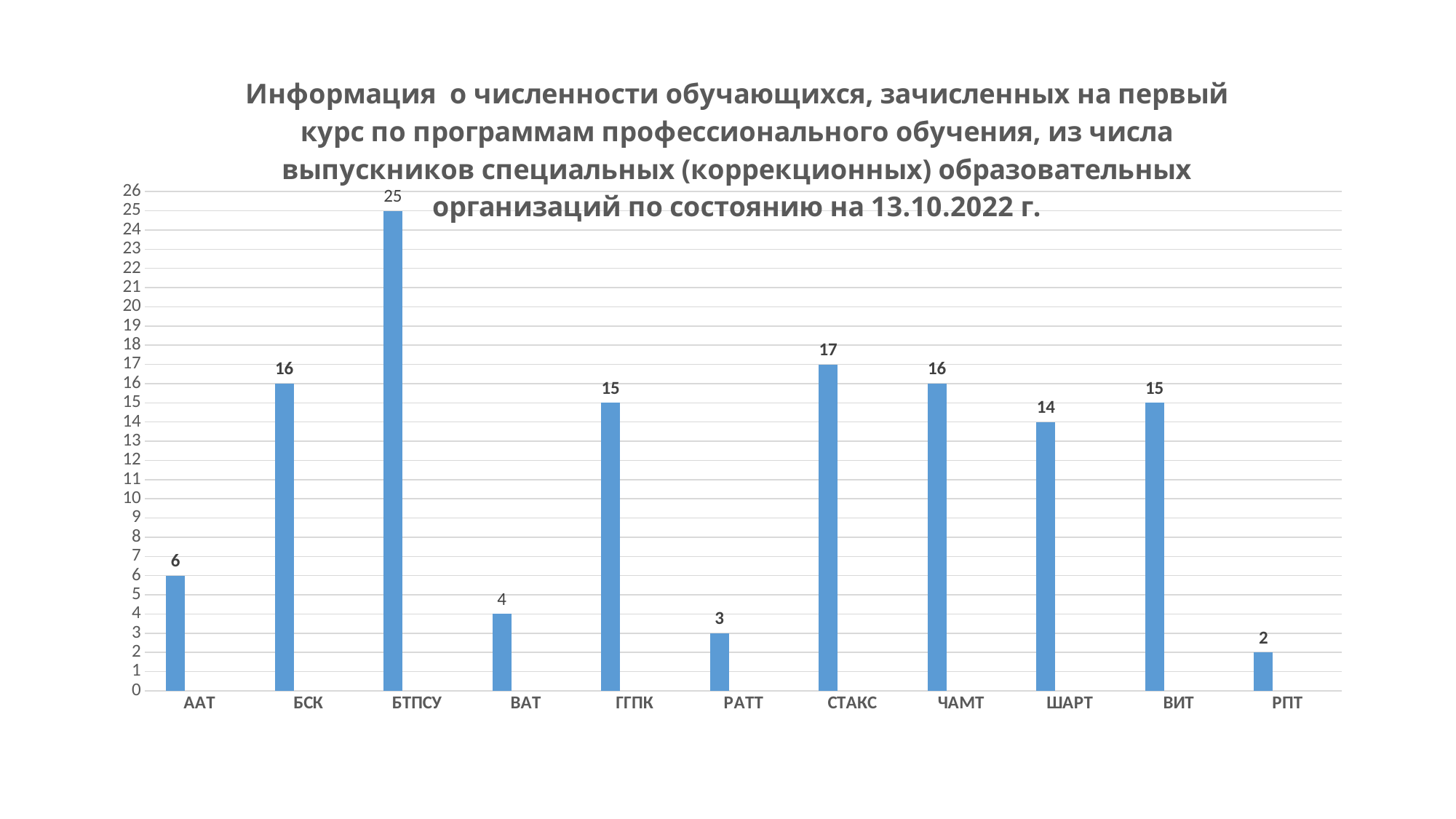
How many categories are shown on the x axis? 11 Which category has the highest value? БТПСУ Which category has the lowest value? РПТ What is the difference between the values for БТПСУ and СТАКС? 8 Which is larger, the value for ААТ or the value for ВАТ? ААТ What is the value for ШАРТ? 14 Is the value for ЧАМТ greater or less than 10? greater What is the value for РПТ? 2 What is the value for БТПСУ? 25 What is the value for СТАКС? 17 What is the total of the values for ГГПК and ВИТ? 30 What kind of chart is shown on the slide? bar chart